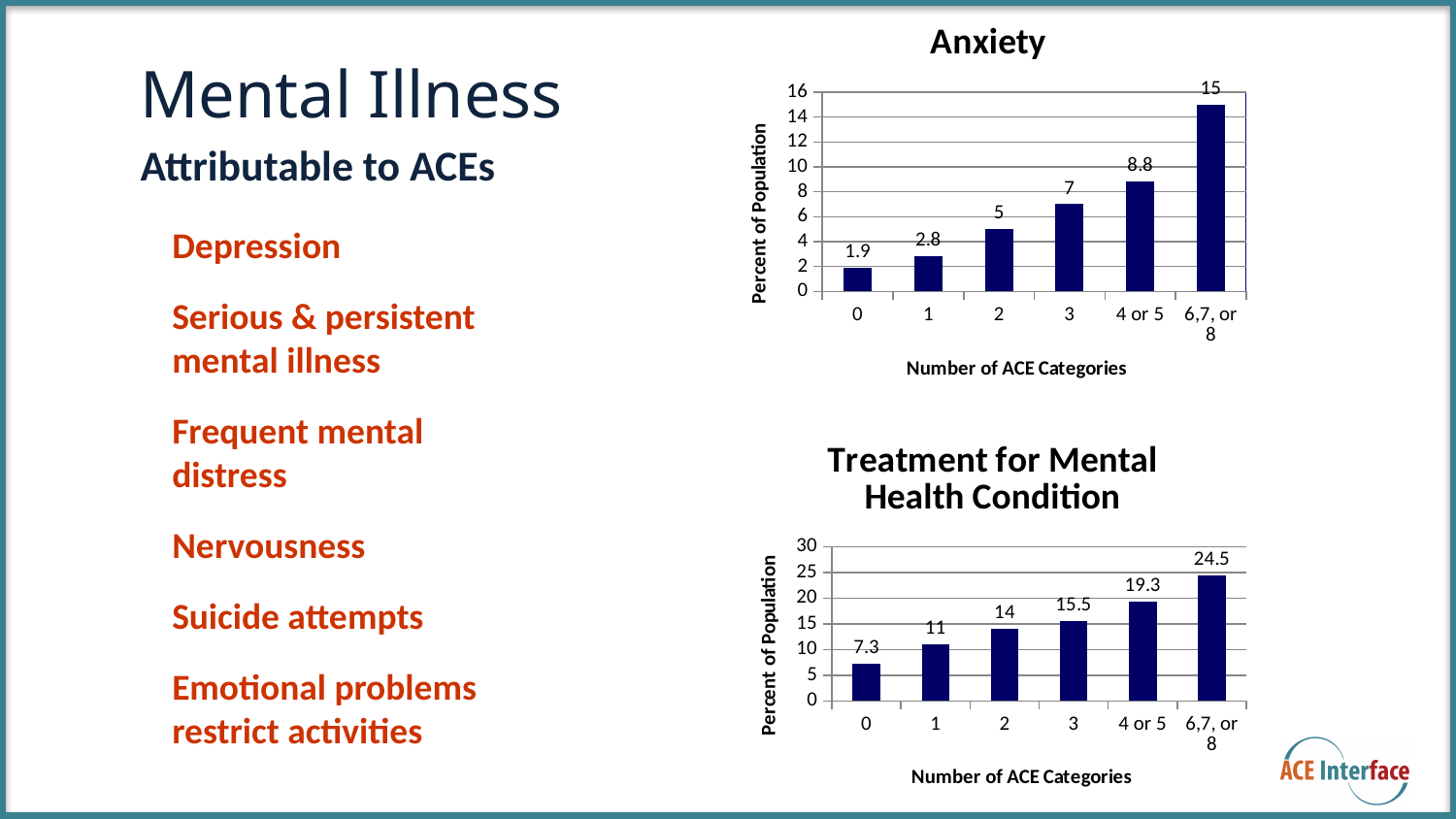
In the Anxiety chart, do the values rise or fall as the number of ACE categories increases? rise In the Anxiety chart, what is the value for 2 ACE categories? 5 In the Anxiety chart, how many categories are shown on the x axis? 6 In the Anxiety chart, which number of ACE categories has the highest percent of population? 6,7, or 8 In the Treatment for Mental Health Condition chart, which is larger, the value for 2 or the value for 1 ACE categories? 2 In the Anxiety chart, what is the value for 1 ACE category? 2.8 In the Treatment for Mental Health Condition chart, what is the difference between the values for 3 and 1 ACE categories? 4.5 In the Anxiety chart, what is the difference between the values for 6,7, or 8 and 0 ACE categories? 13.1 What is the y-axis label of the Anxiety chart? Percent of Population What kind of chart is the Treatment for Mental Health Condition chart? bar chart In the Treatment for Mental Health Condition chart, what is the value for 4 or 5 ACE categories? 19.3 In the Treatment for Mental Health Condition chart, which number of ACE categories has the lowest value? 0